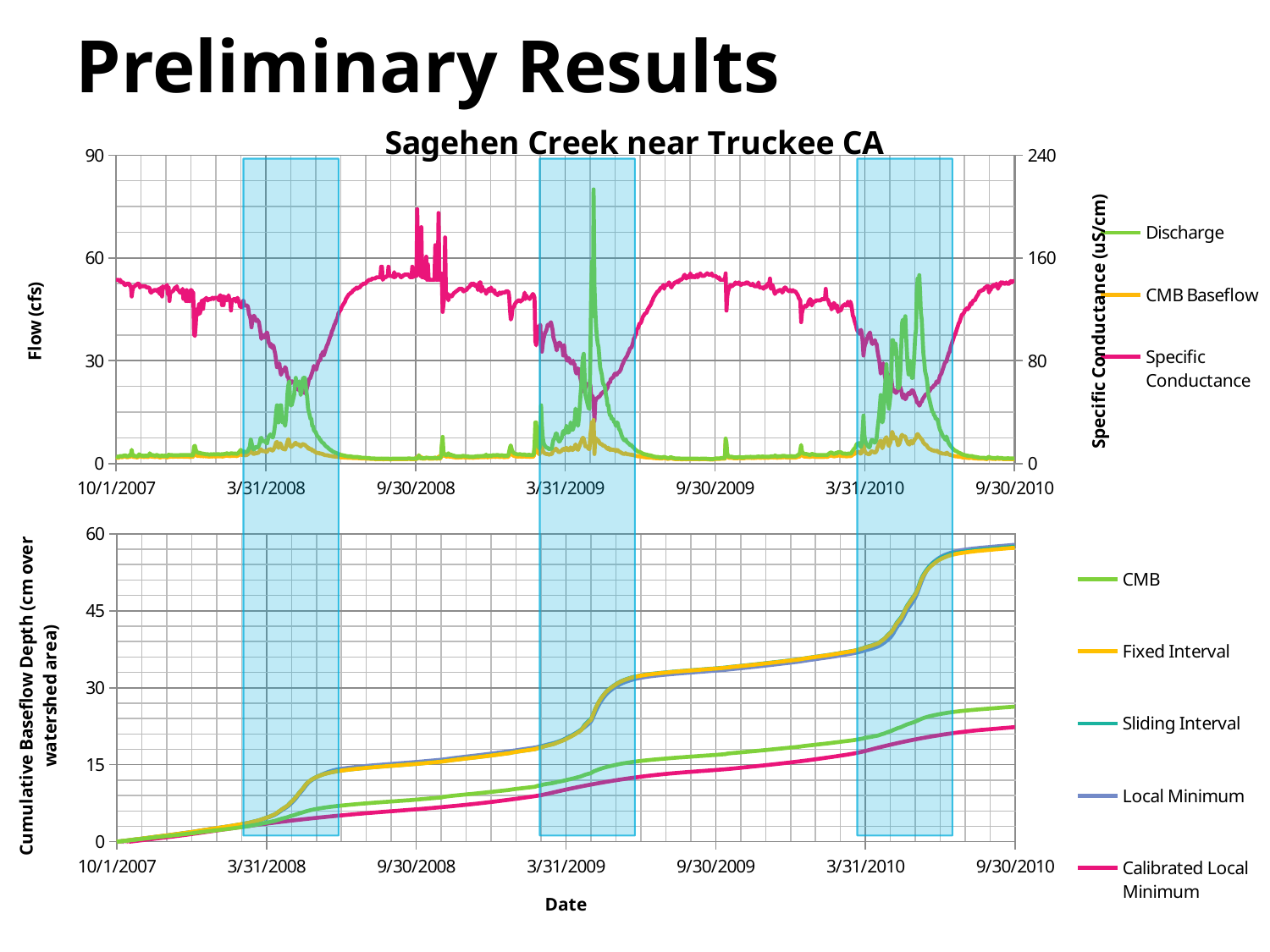
In the top chart, is the peak Discharge value near 3/31/2009 greater or less than 60 cfs? greater In the bottom chart, which series has the lowest value at 9/30/2010? Calibrated Local Minimum In the bottom chart, do the series values rise or fall from 10/1/2007 to 9/30/2010? rise How many series does the legend of the top chart list? 3 What is the label of the left vertical axis of the top chart? Flow (cfs) How many series does the legend of the bottom chart list? 5 What kind of chart is the bottom chart? line chart What is the title of the top chart? Sagehen Creek near Truckee CA In the bottom chart, is the Calibrated Local Minimum value at 9/30/2010 greater or less than 30? less In the bottom chart, is the Local Minimum value at 9/30/2010 greater or less than 45? greater In the bottom chart, at 9/30/2010, which is larger: Fixed Interval or CMB? Fixed Interval